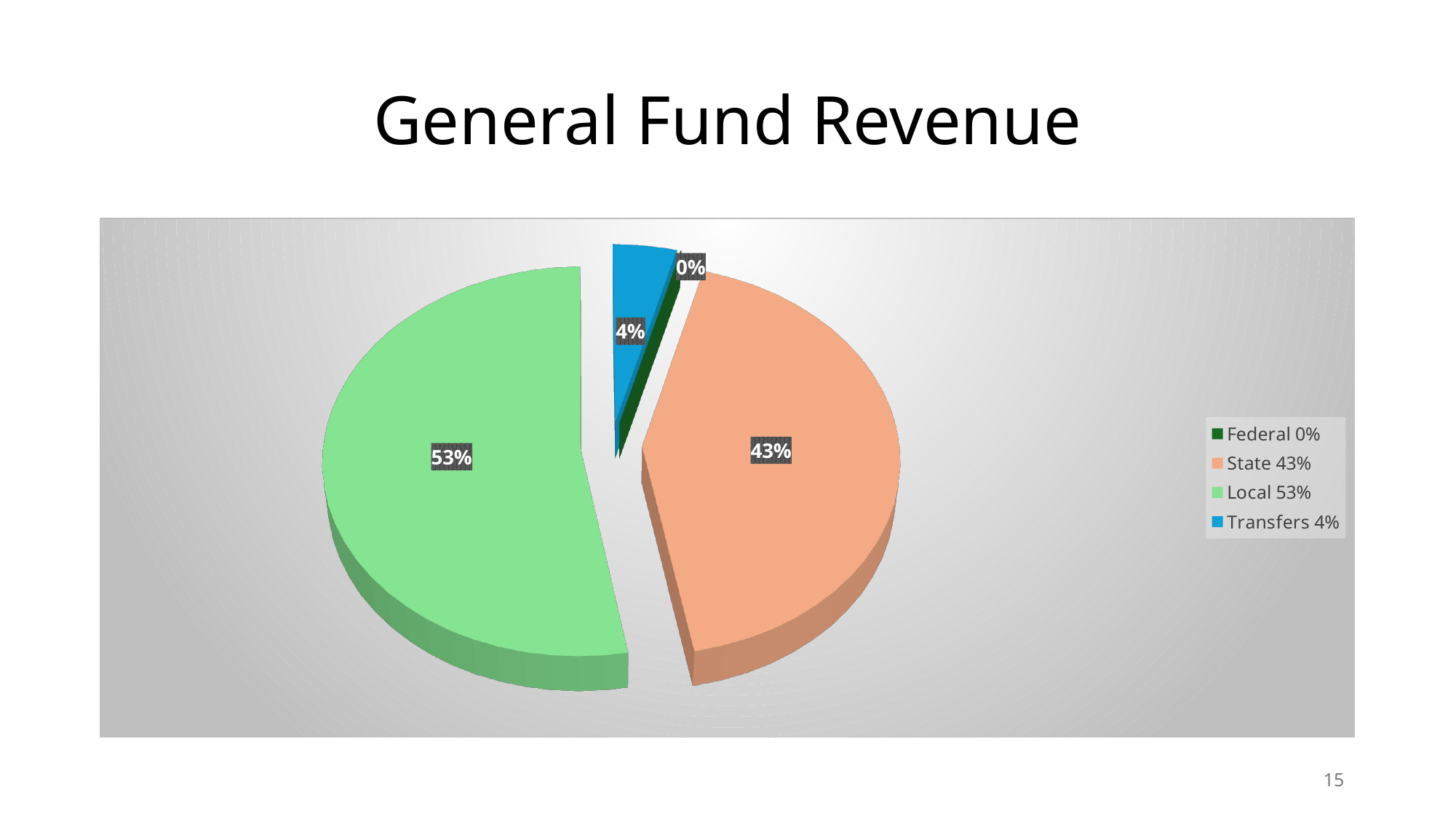
What share of General Fund Revenue comes from Federal sources? 0% What share of General Fund Revenue comes from State sources? 43% What share of General Fund Revenue comes from Transfers? 4% Which revenue source has the smallest share of General Fund Revenue? Federal What share of General Fund Revenue comes from Local sources? 53% What is the difference in percentage points between the Local and State shares? 10 What is the title of the chart? General Fund Revenue Which is larger, the State share or the Transfers share? State What kind of chart is shown on the slide? Pie chart Which revenue source has the largest share of General Fund Revenue? Local How many revenue categories are shown in the pie chart? 4 What colour is the Transfers slice in the pie chart? Blue